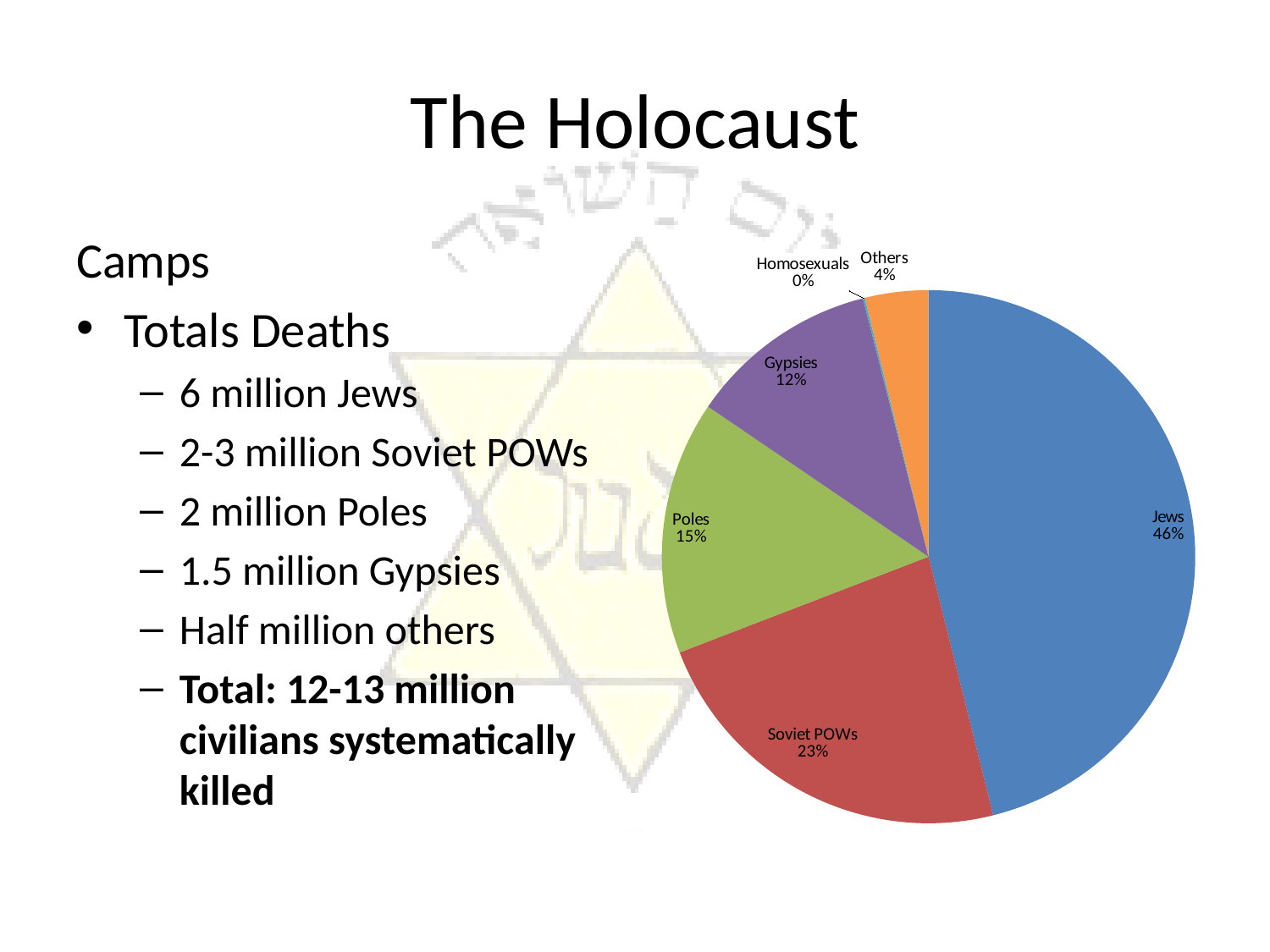
What percentage is shown for Homosexuals? 0% What percentage is shown for Others? 4% How many categories are shown in the pie chart? 6 Which slice is larger, Poles or Gypsies? Poles Which category has the smallest slice of the pie? Homosexuals Which category has the largest slice of the pie? Jews What percentage of the pie does the Jews slice represent? 46% What percentage is shown for Soviet POWs? 23% What is the difference in percentage points between the Jews slice and the Soviet POWs slice? 23 What percentage is shown for Gypsies? 12% What percentage is shown for Poles? 15% What kind of chart is shown on the slide? pie chart